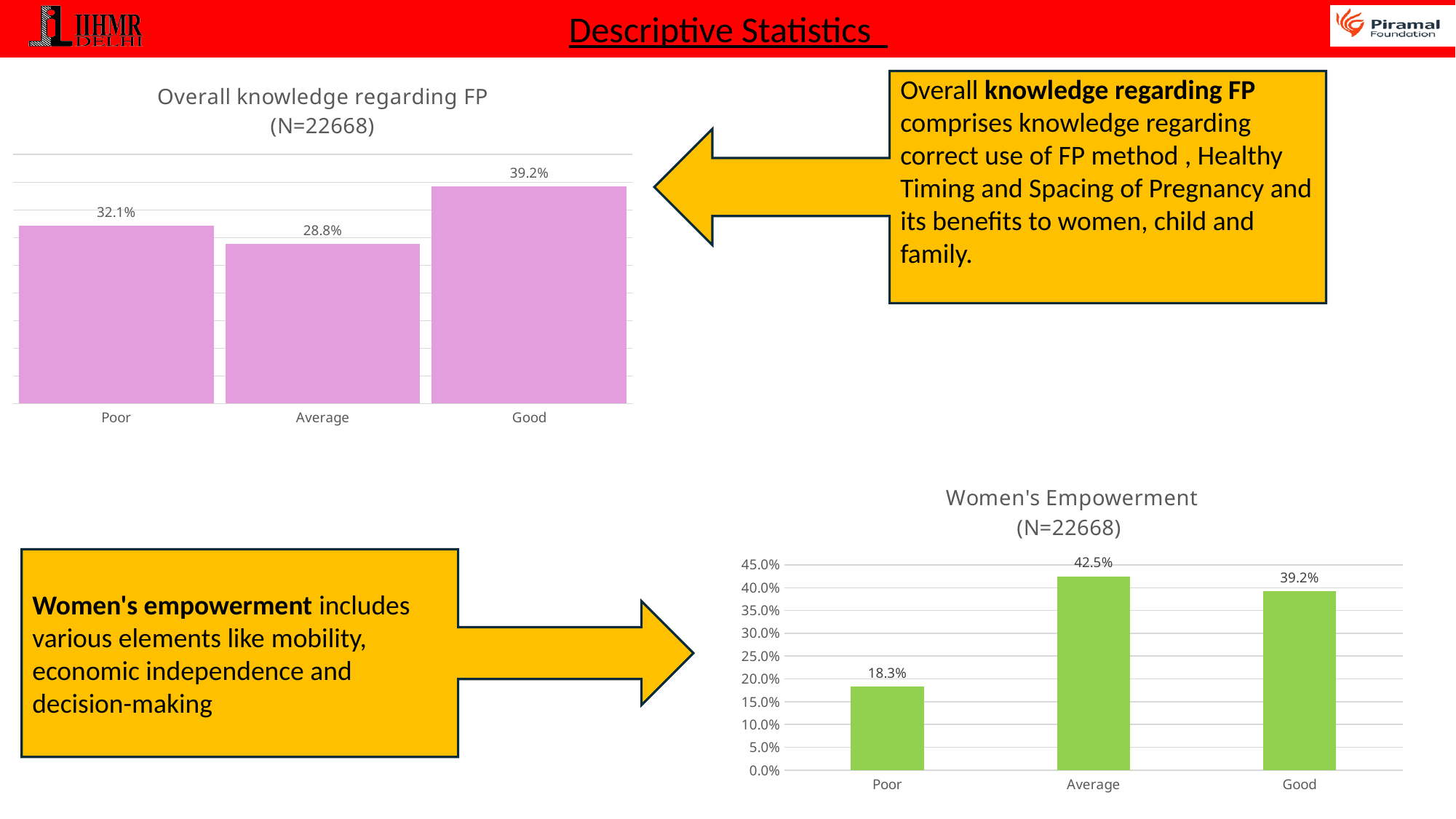
In the 'Overall knowledge regarding FP' chart, what is the difference between Good and Poor? 7.1% In the 'Women's Empowerment' chart, is the value for Poor greater or less than 20.0%? less In the 'Overall knowledge regarding FP' chart, what is the value for Good? 39.2% In the 'Overall knowledge regarding FP' chart, which category has the lowest value? Average In the 'Women's Empowerment' chart, what is the difference between Average and Poor? 24.2% In the 'Women's Empowerment' chart, what is the value for Poor? 18.3% What sample size (N) is shown in the title of the 'Overall knowledge regarding FP' chart? N=22668 What kind of chart is the 'Women's Empowerment' chart? Bar chart In the 'Women's Empowerment' chart, which category has the highest value? Average In the 'Women's Empowerment' chart, which is larger, the value for Average or the value for Good? Average In the 'Overall knowledge regarding FP' chart, how many categories are shown? 3 In the 'Overall knowledge regarding FP' chart, what is the value for Average? 28.8%